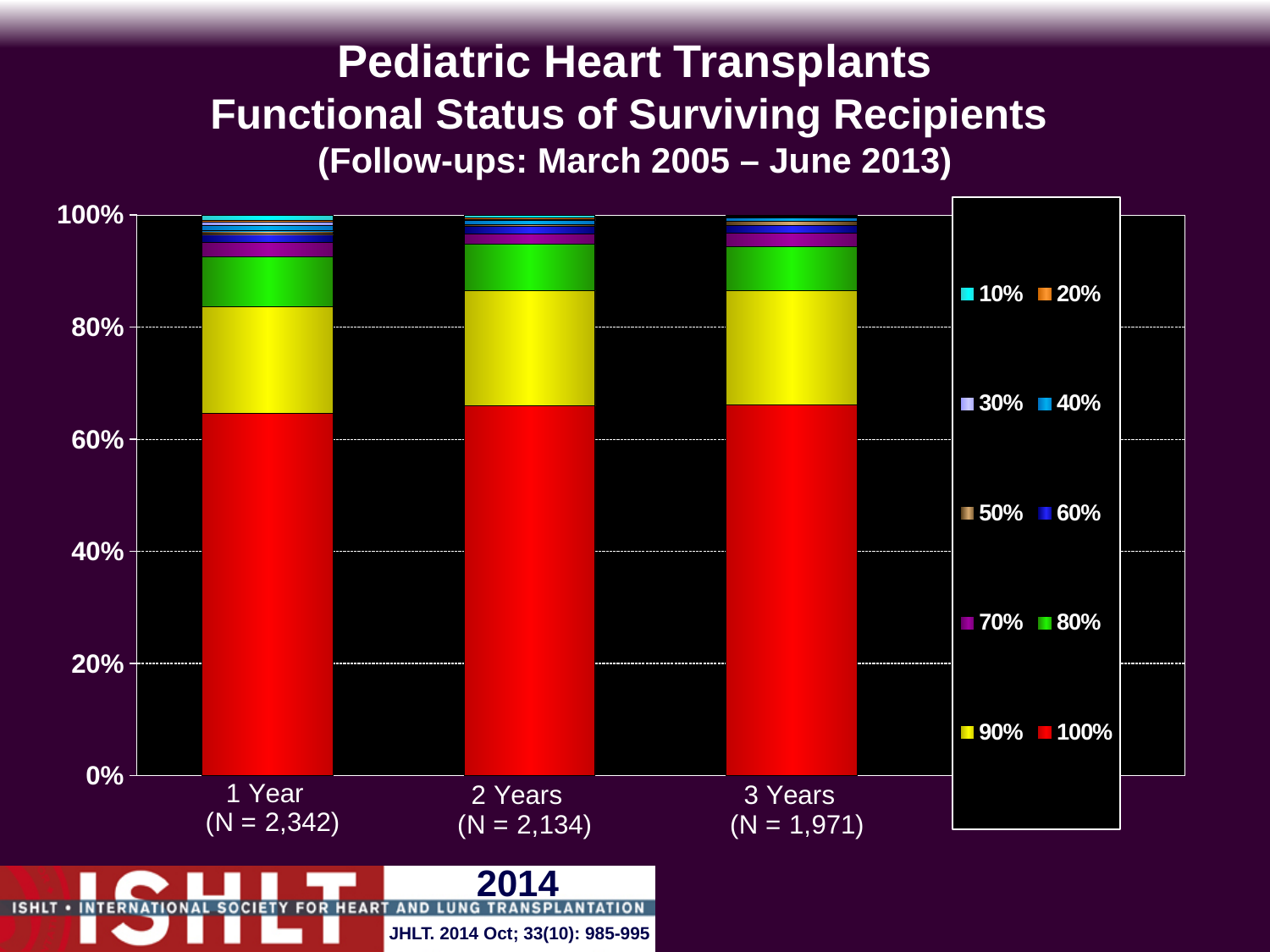
How many follow-up time categories are shown on the x axis? 3 Which functional status category occupies the largest segment in every bar? 100% What is the total height of each stacked bar? 100% What is the N shown for the 1 Year category? N = 2,342 Is the share of the 100% functional status segment for 3 Years greater or less than 60%? greater What kind of chart is shown on the slide? Stacked bar chart How many series does the legend list? 10 Is the share of the 100% functional status segment for 1 Year greater or less than 80%? less Is the share of the 100% functional status segment for 2 Years greater or less than 80%? less What colour represents the 100% functional status series in the legend? Red